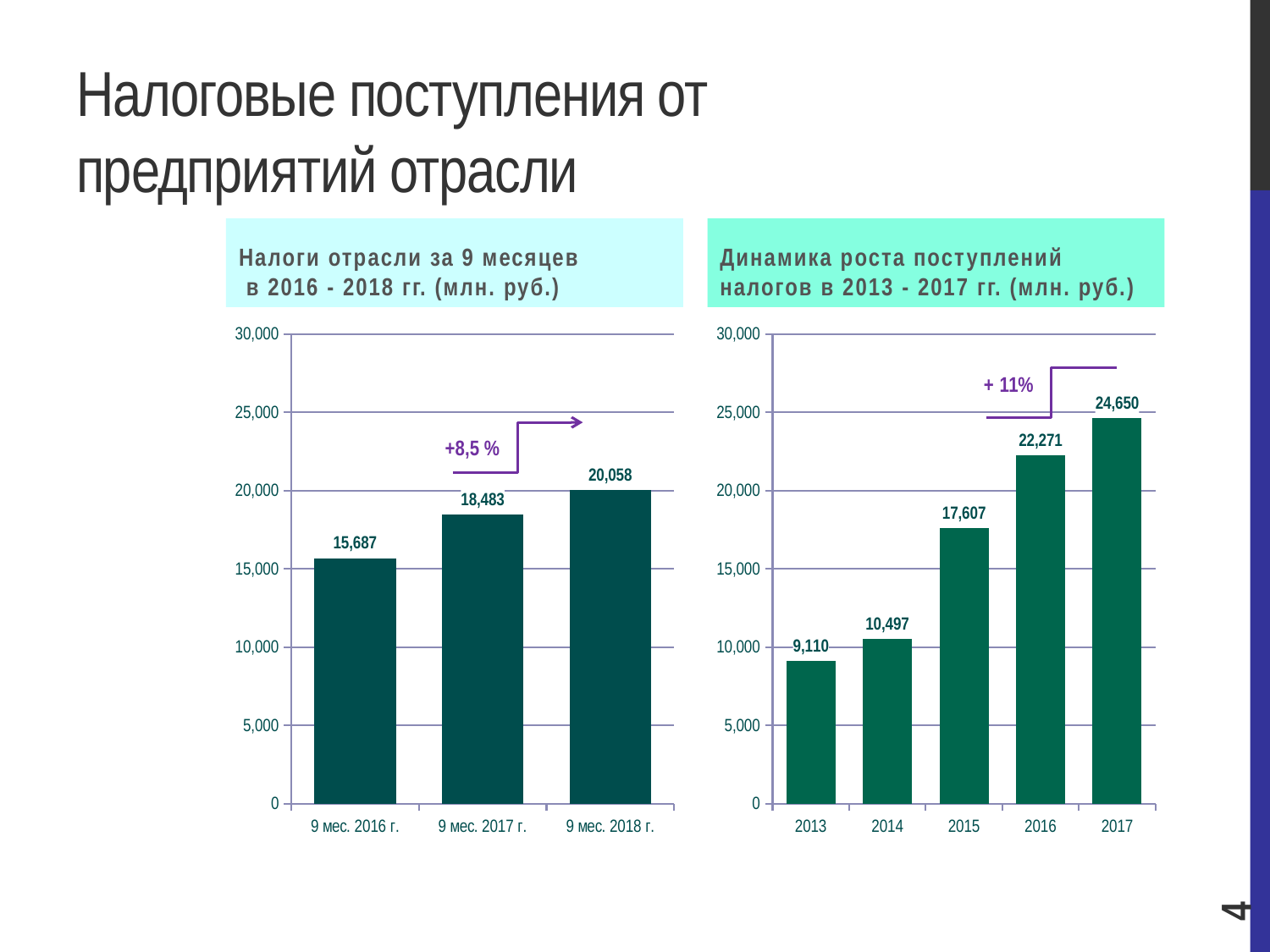
In the left chart (Налоги отрасли за 9 месяцев в 2016 - 2018 гг.), how many bars are plotted? 3 What type of chart is the right chart (Динамика роста поступлений налогов в 2013 - 2017 гг.)? bar chart In the right chart (Динамика роста поступлений налогов в 2013 - 2017 гг.), do the values rise or fall from 2013 to 2017? rise In the left chart (Налоги отрасли за 9 месяцев в 2016 - 2018 гг.), what percentage growth is annotated between 9 мес. 2017 г. and 9 мес. 2018 г.? +8,5 % In the left chart (Налоги отрасли за 9 месяцев в 2016 - 2018 гг.), which category has the highest value? 9 мес. 2018 г. In the left chart (Налоги отрасли за 9 месяцев в 2016 - 2018 гг.), what is the value for 9 мес. 2017 г.? 18,483 In the right chart (Динамика роста поступлений налогов в 2013 - 2017 гг.), what is the value for 2015? 17,607 In the right chart (Динамика роста поступлений налогов в 2013 - 2017 гг.), what is the difference between the values for 2017 and 2016? 2,379 In the right chart (Динамика роста поступлений налогов в 2013 - 2017 гг.), is the value for 2014 greater or less than 10,000? greater In the right chart (Динамика роста поступлений налогов в 2013 - 2017 гг.), how many years are plotted? 5 In the right chart (Динамика роста поступлений налогов в 2013 - 2017 гг.), which year has the lowest value? 2013 In the left chart (Налоги отрасли за 9 месяцев в 2016 - 2018 гг.), what is the difference between the values for 9 мес. 2018 г. and 9 мес. 2016 г.? 4,371